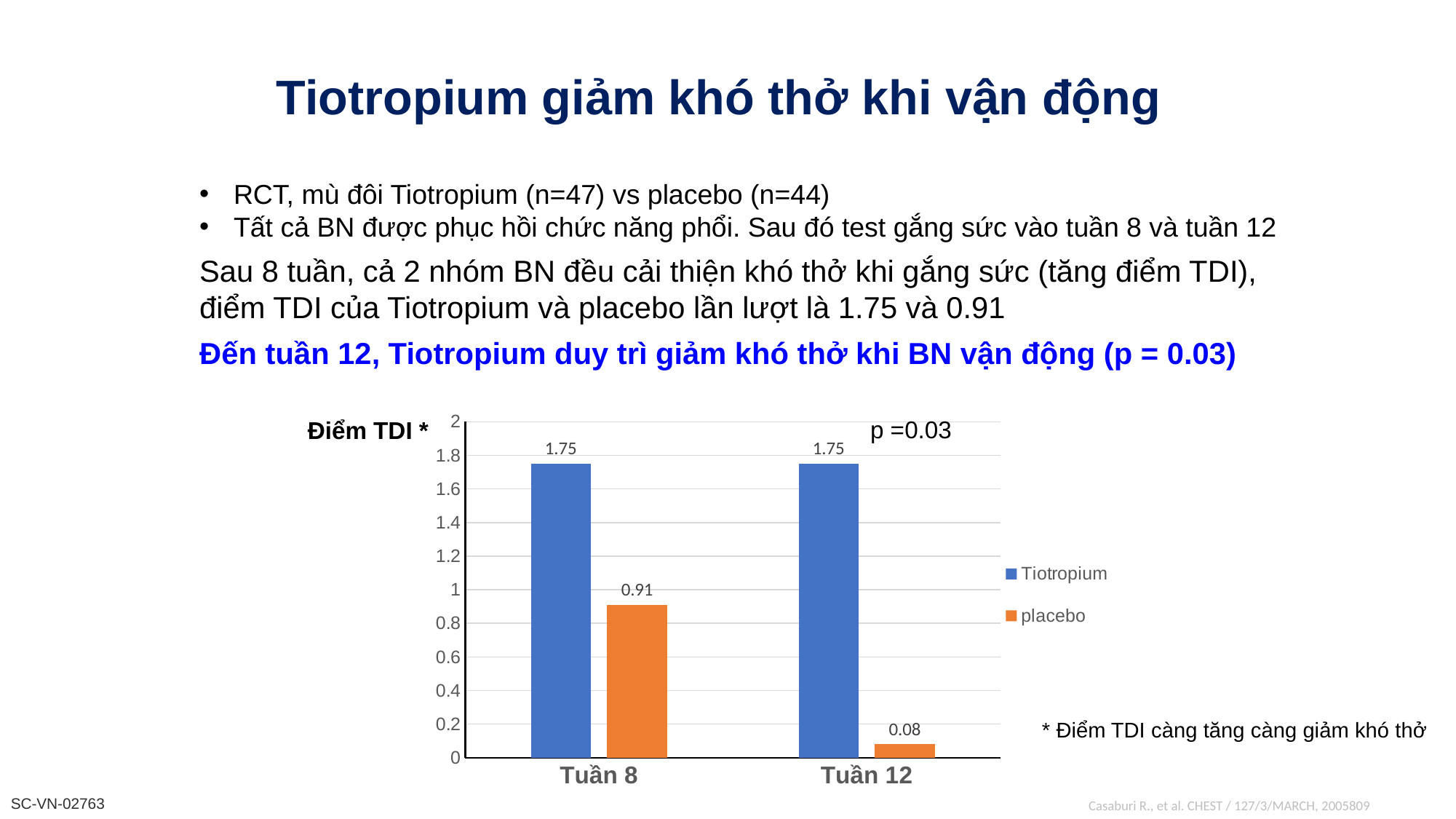
How many series does the legend list? 2 What is the TDI score for placebo at Tuần 12? 0.08 What is the difference between the Tiotropium and placebo values at Tuần 12? 1.67 Which series has the lowest value at Tuần 12? placebo What kind of chart is shown on the slide? bar chart Does the placebo value rise or fall from Tuần 8 to Tuần 12? fall What is the TDI score for Tiotropium at Tuần 8? 1.75 Is the placebo value at Tuần 8 greater or less than 1? less How many categories are shown on the x axis? 2 What is the TDI score for placebo at Tuần 8? 0.91 What is the difference between the Tiotropium and placebo values at Tuần 8? 0.84 Which is larger at Tuần 8, Tiotropium or placebo? Tiotropium